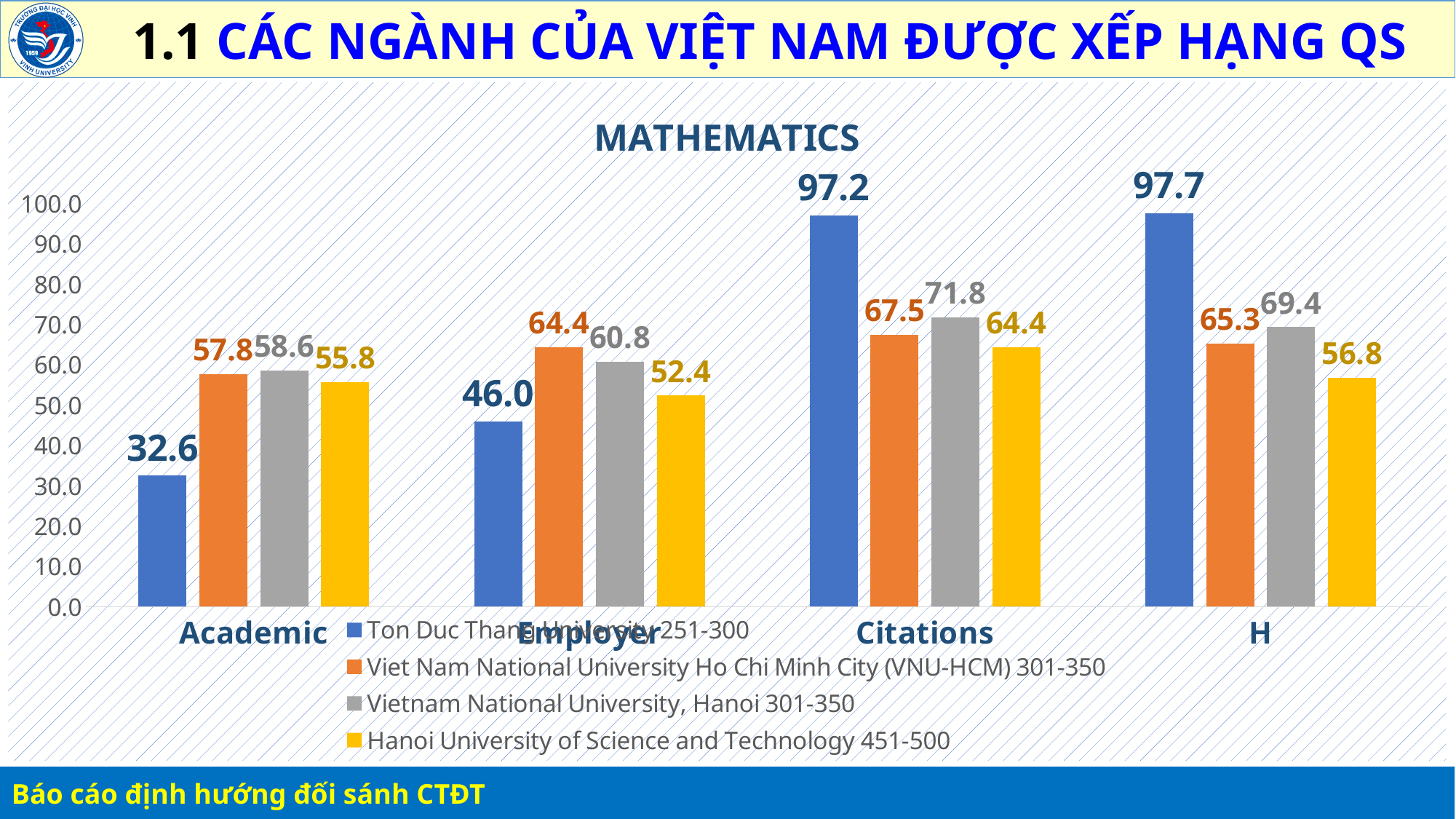
In the Employer category, which is larger: the value for Vietnam National University, Hanoi or the value for Hanoi University of Science and Technology? Vietnam National University, Hanoi Is the value for Ton Duc Thang University in the Employer category greater or less than 50.0? less How many series does the legend list? 4 Which university has the lowest value in the Academic category? Ton Duc Thang University What type of chart is shown on the slide? bar chart What is the difference between Ton Duc Thang University's H value and its Academic value? 65.1 What is the value for Hanoi University of Science and Technology in the H category? 56.8 How many categories are shown on the x axis? 4 What is the value for Ton Duc Thang University in the Academic category? 32.6 What is the value for Viet Nam National University Ho Chi Minh City (VNU-HCM) in the Employer category? 64.4 Which university has the highest value in the Citations category? Ton Duc Thang University What is the value for Vietnam National University, Hanoi in the Citations category? 71.8